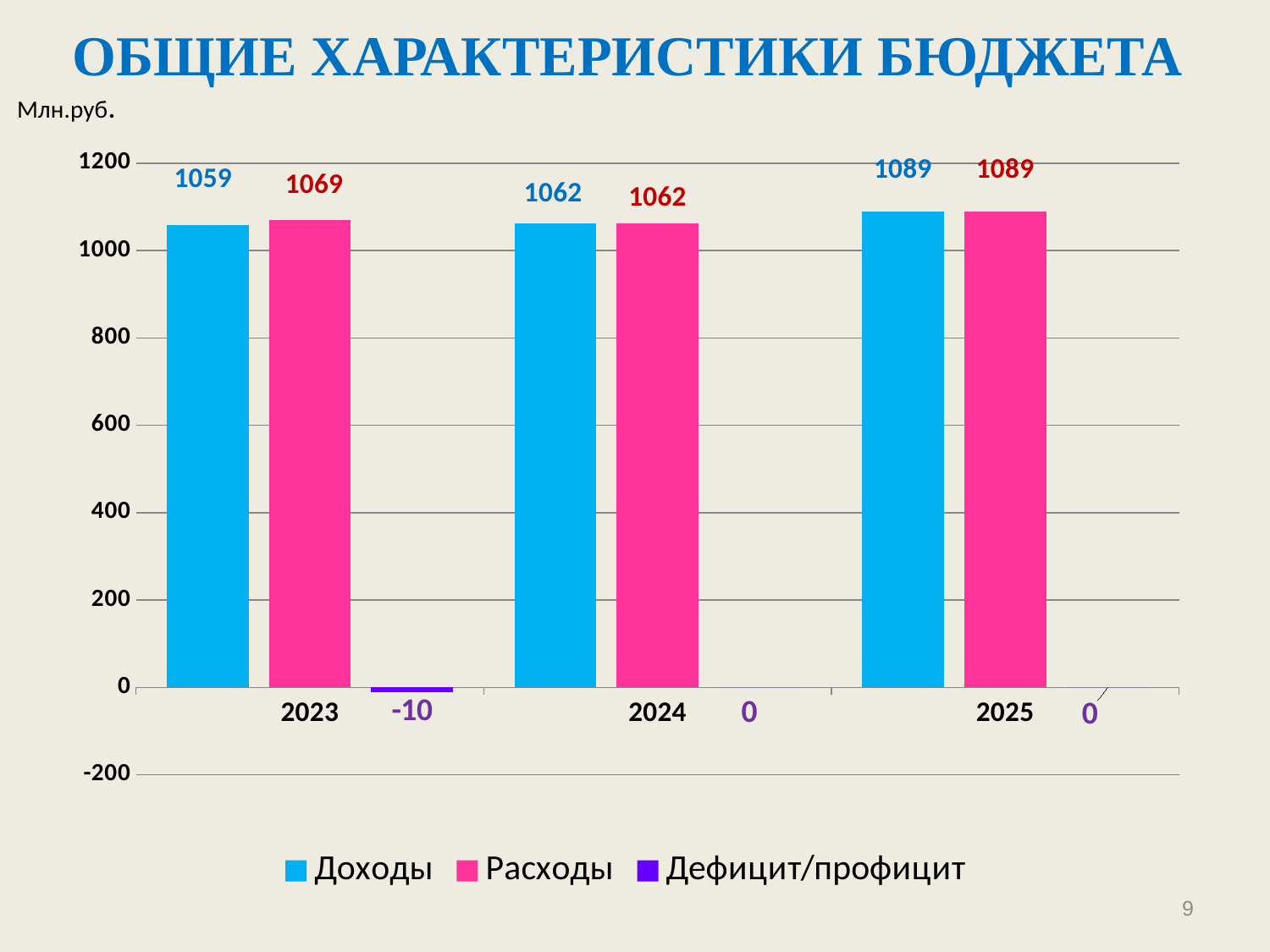
Which is larger in 2023, Доходы or Расходы? Расходы What is the value of Дефицит/профицит for 2023? -10 Do the Доходы values rise or fall from 2023 to 2025? Rise In which year is Доходы highest? 2025 What is the value of Расходы for 2023? 1069 What kind of chart is shown on the slide? Bar chart What is the value of Расходы for 2025? 1089 How many series does the legend list? 3 In which year is Доходы lowest? 2023 What is the difference between Доходы in 2025 and Доходы in 2024? 27 What is the difference between Расходы and Доходы in 2023? 10 What is the value of Доходы for 2023? 1059